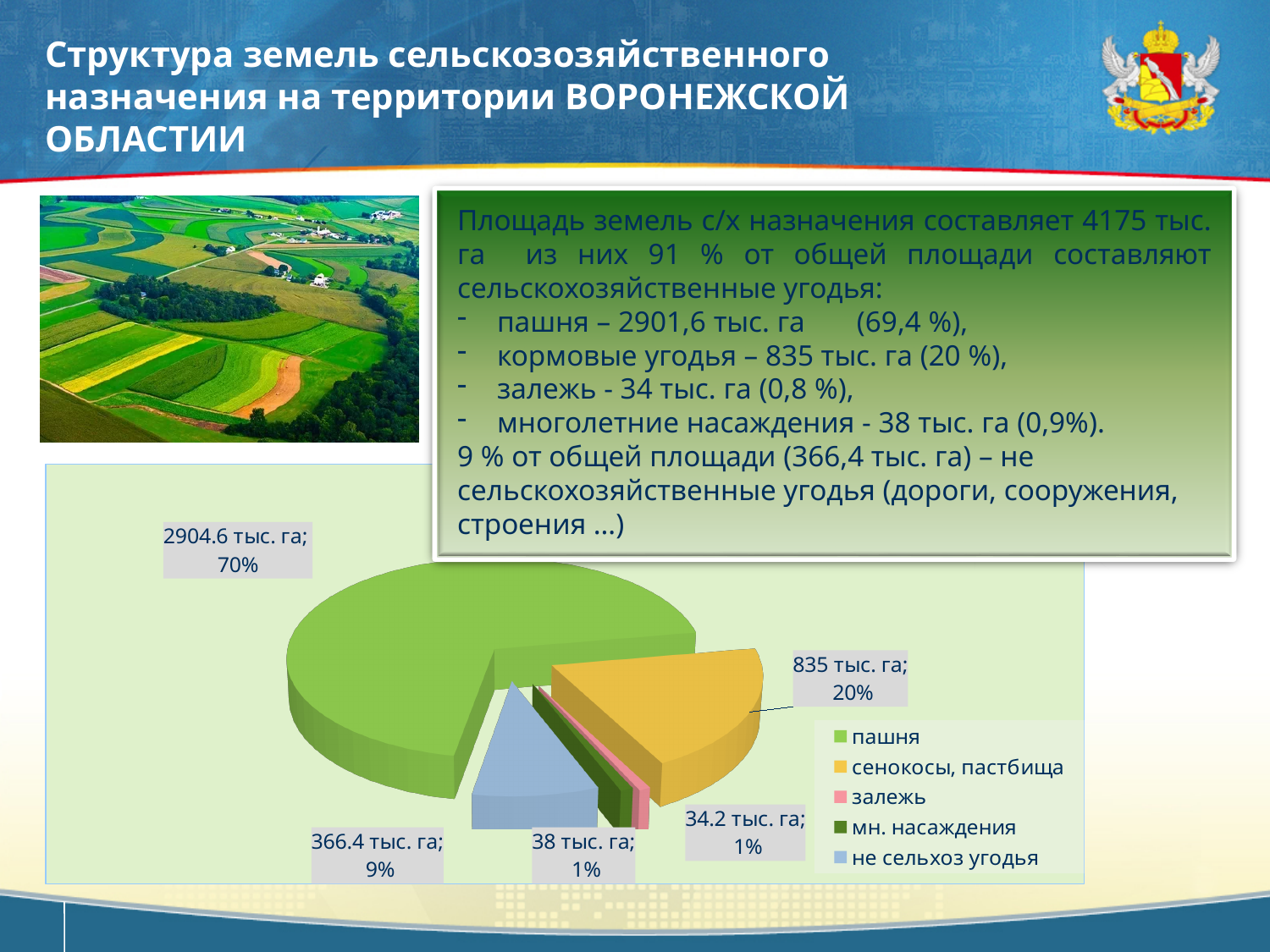
What share of the pie does сенокосы, пастбища take? 20% Which category has the smallest value in the pie chart? залежь What value is shown for сенокосы, пастбища in the pie chart? 835 тыс. га How many entries does the legend of the pie chart list? 5 What value is shown for пашня in the pie chart? 2904.6 тыс. га What share of the pie does пашня take? 70% What kind of chart is shown on the slide? pie chart Which category has the largest slice in the pie chart? пашня What value is shown for не сельхоз угодья in the pie chart? 366.4 тыс. га How many categories does the pie chart show? 5 What is the difference between the values for пашня and сенокосы, пастбища? 2069.6 тыс. га Which colour represents пашня in the pie chart? green